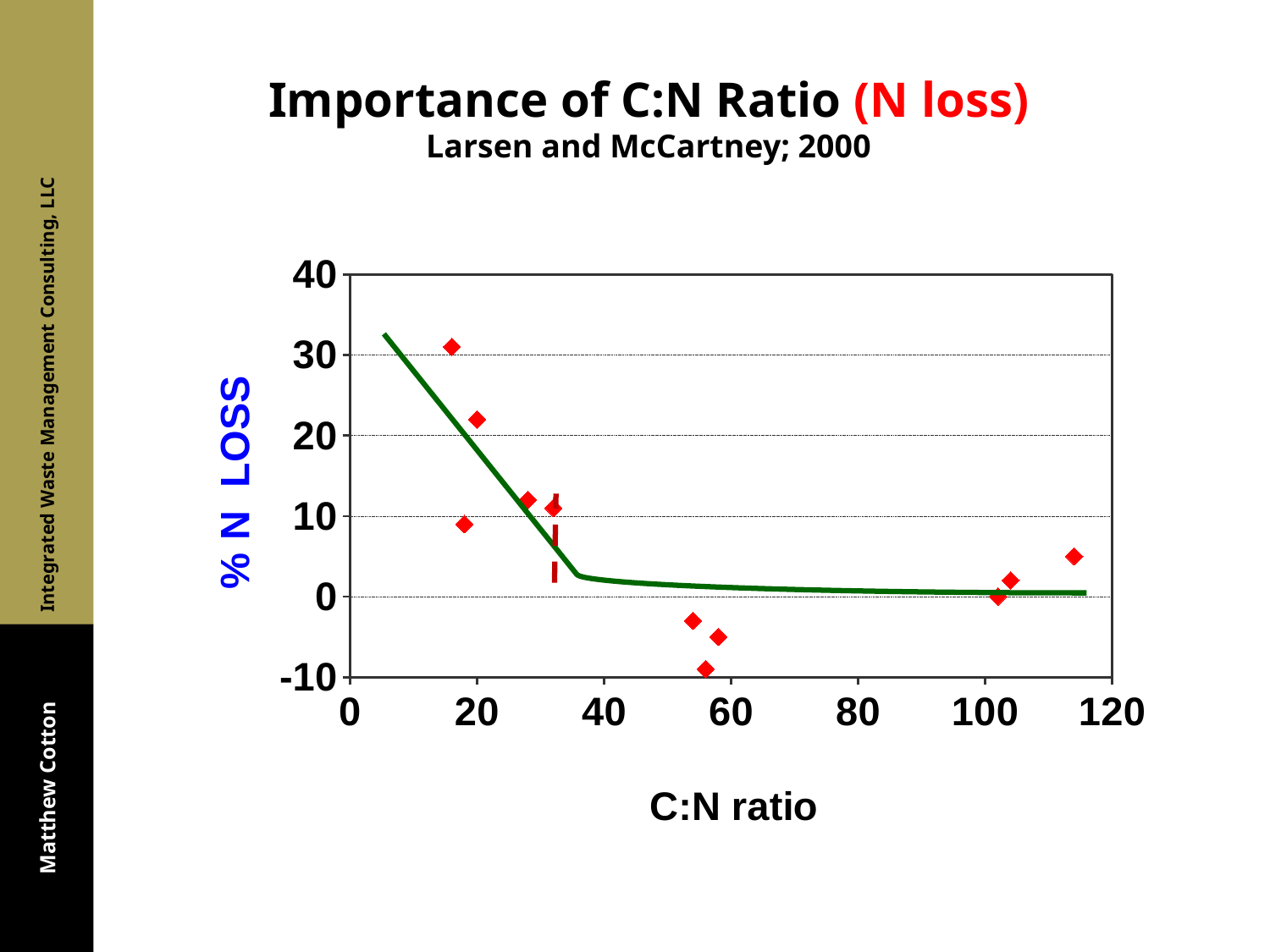
What is the label of the x axis? C:N ratio Are the data points with the lowest % N loss found at C:N ratios below 40 or between 40 and 80? Between 40 and 80 What is the label of the y axis? % N LOSS What is the maximum value shown on the y axis? 40 Is the % N loss for the data point at a C:N ratio of about 114 greater or less than 10? less Is the % N loss for the data point with the lowest C:N ratio (around 16) greater or less than 20? greater Does % N loss generally rise or fall as the C:N ratio increases along the x axis? Fall Which data point has the highest % N loss: the one at a C:N ratio of about 16 or the one at about 114? The one at about 16 Is the % N loss for the data point at a C:N ratio of about 20 greater or less than 10? greater What kind of chart is shown on the slide? Scatter plot How many data points are plotted on the chart? 11